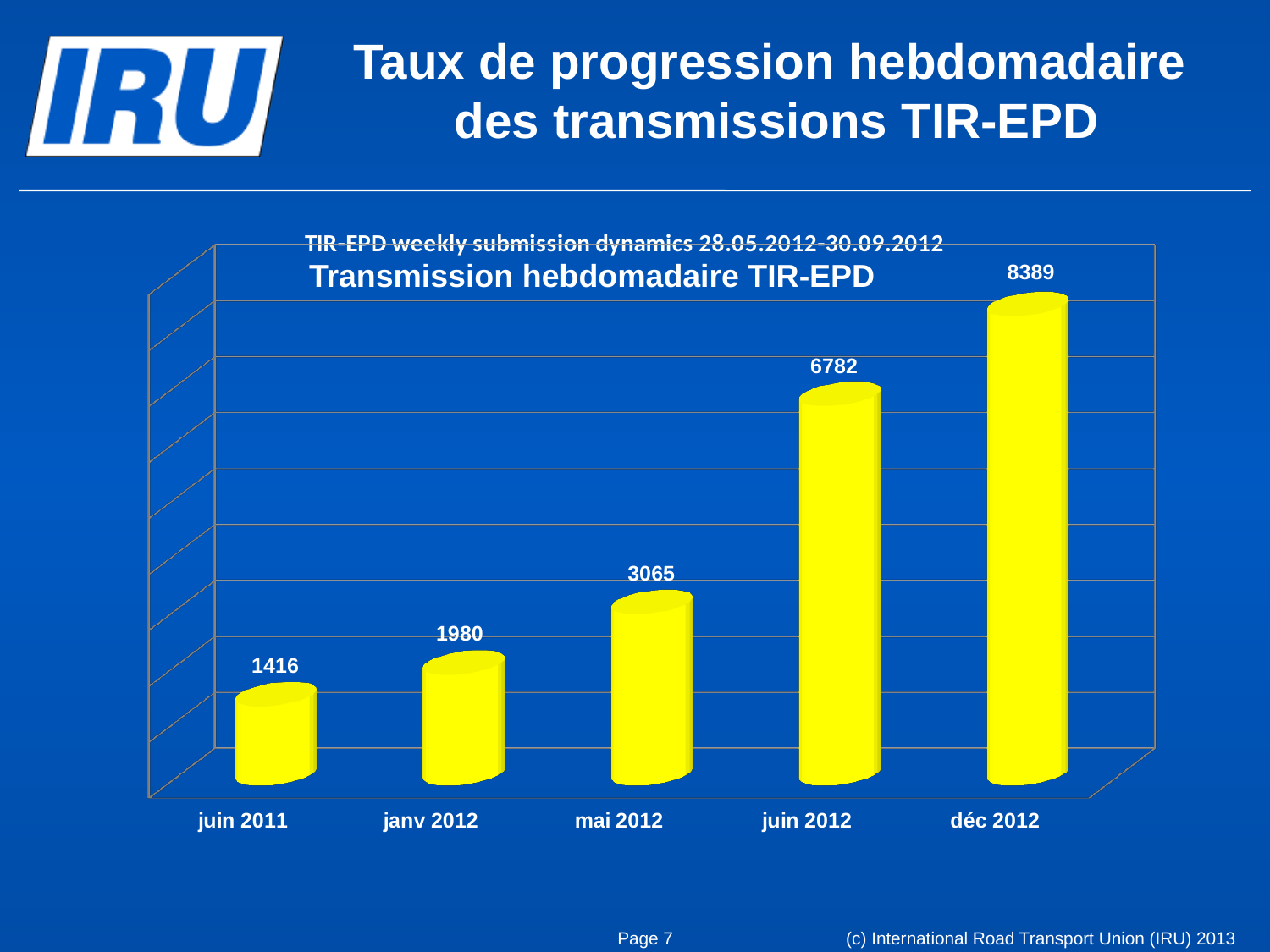
What is the value for déc 2012? 8389 What is the value for mai 2012? 3065 How many categories are shown on the x axis? 5 What kind of chart is shown on the slide? bar chart What is the difference between the values for déc 2012 and juin 2012? 1607 Which category has the highest value? déc 2012 What is the value for juin 2011? 1416 What is the difference between the values for janv 2012 and juin 2011? 564 What colour are the bars in the chart? yellow Which category has the lowest value? juin 2011 Which is larger, the value for mai 2012 or the value for janv 2012? mai 2012 Do the values rise or fall from juin 2011 to déc 2012? rise